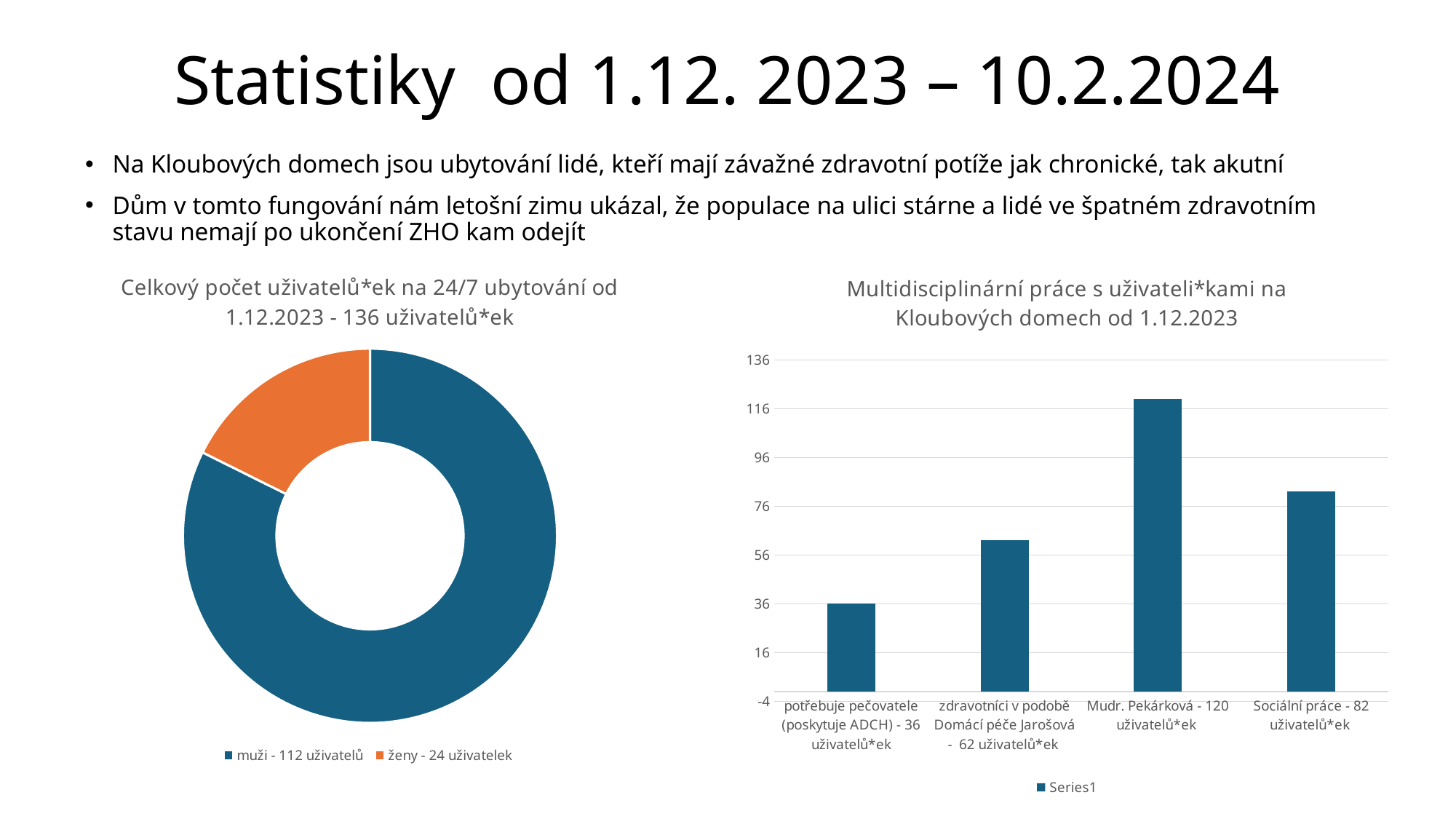
In the right bar chart, which category has the lowest bar? potřebuje pečovatele (poskytuje ADCH) - 36 uživatelů*ek In the left doughnut chart, how many slices are there? 2 In the right bar chart, how many categories are shown on the x axis? 4 What kind of chart is the left chart titled 'Celkový počet uživatelů*ek na 24/7 ubytování od 1.12.2023 - 136 uživatelů*ek'? doughnut chart In the right bar chart, which category has the highest bar? Mudr. Pekárková - 120 uživatelů*ek In the left doughnut chart, what is the difference between the number of muži and ženy? 88 In the left doughnut chart, how many users does the legend give for 'ženy'? 24 uživatelek What kind of chart is the right chart titled 'Multidisciplinární práce s uživateli*kami na Kloubových domech od 1.12.2023'? bar chart In the right bar chart, is the value for 'Sociální práce' greater or less than 76? greater In the right bar chart, how many series does the legend list? 1 In the left doughnut chart, how many users does the legend give for 'muži'? 112 uživatelů In the left doughnut chart, which group is larger, muži or ženy? muži